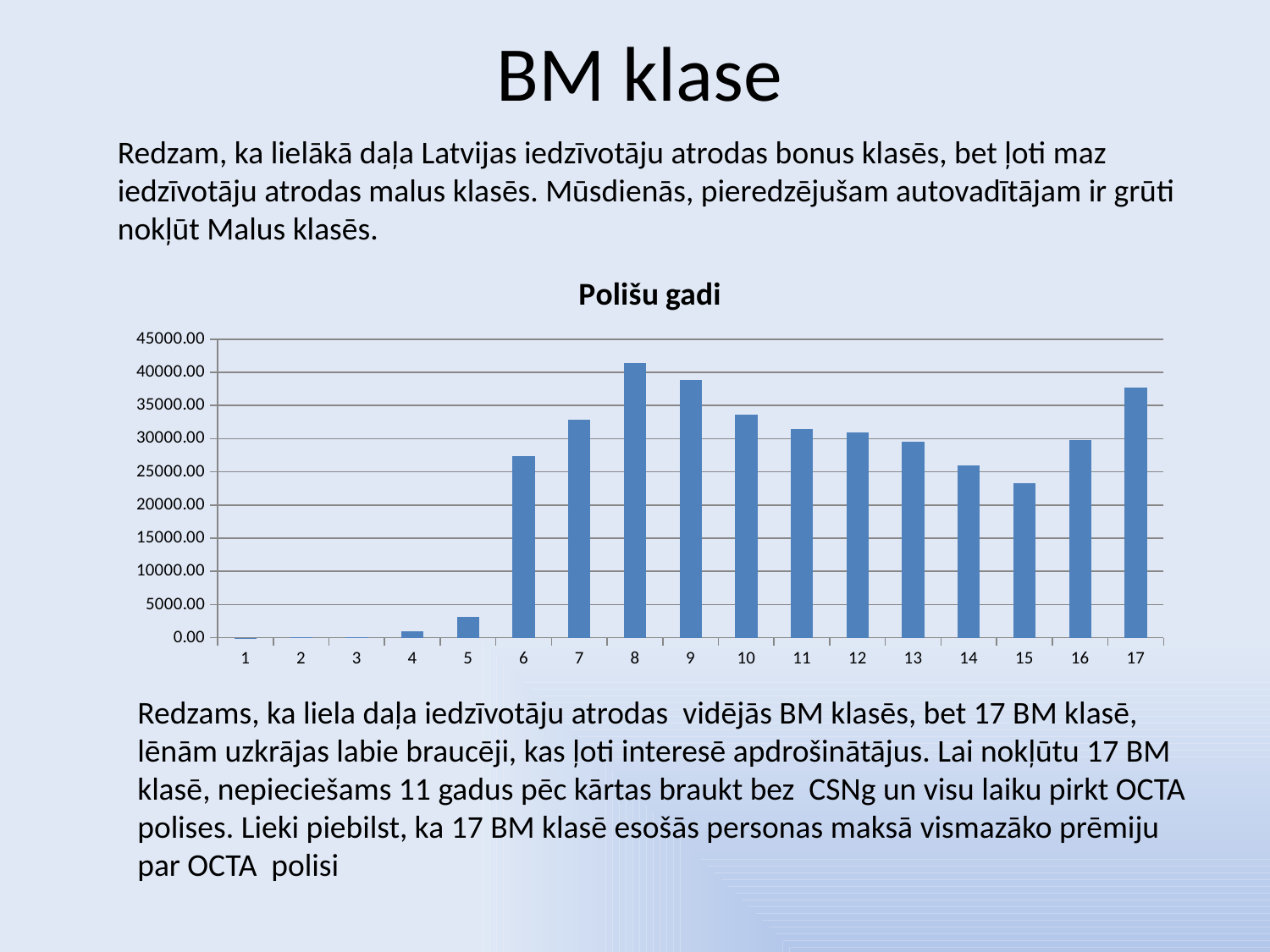
Which has a larger value, category 14 or category 15? 14 Is the value for category 8 greater or less than 40000.00? greater Which category has the highest value in the chart? 8 Do the values rise or fall from category 8 to category 15? fall What type of chart is shown on the slide? bar chart Is the value for category 15 greater or less than 25000.00? less Is the value for category 6 greater or less than 25000.00? greater Which has a larger value, category 8 or category 9? 8 How many categories are shown on the x axis of the chart? 17 What is the title of the chart? Polišu gadi